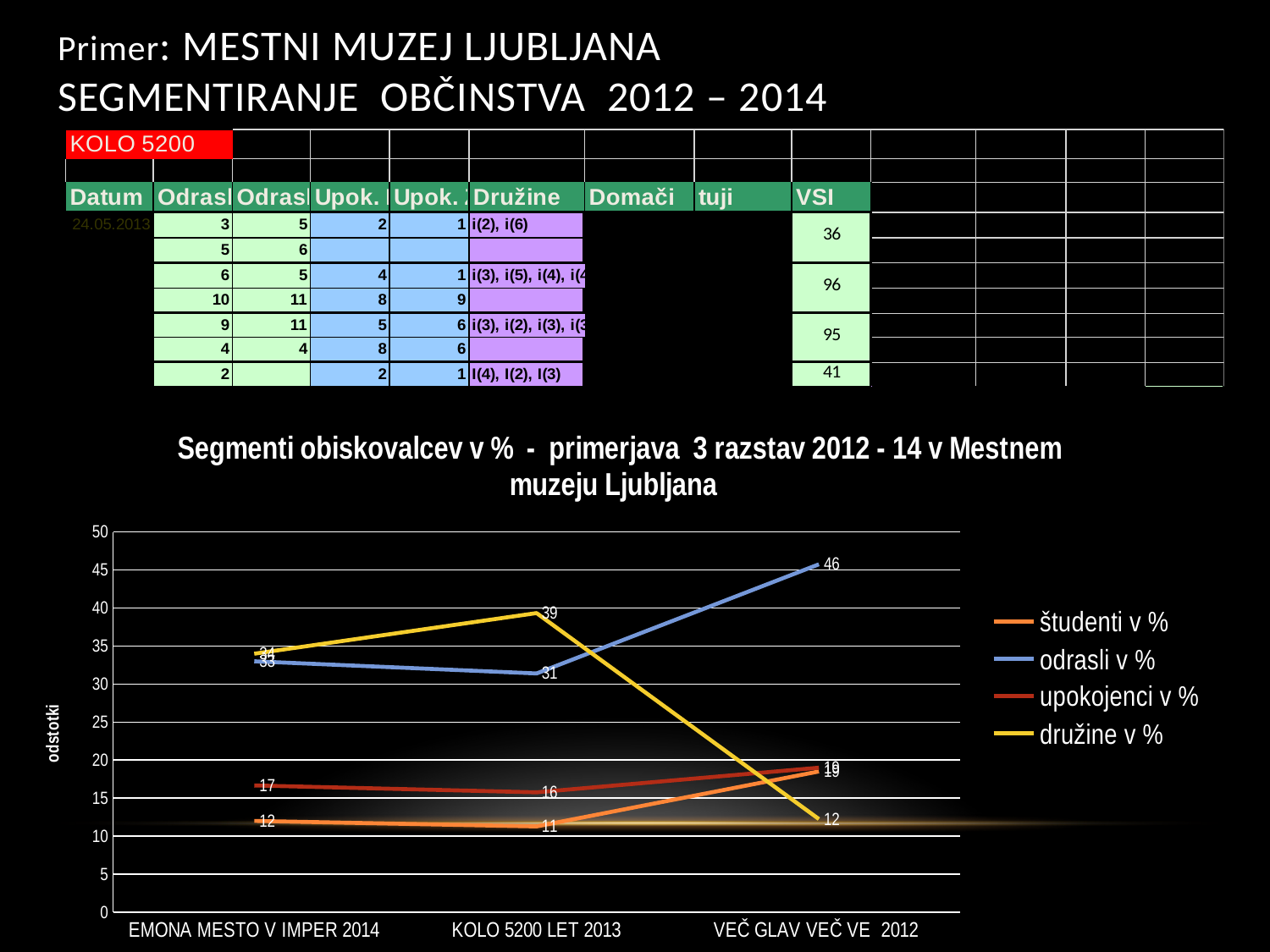
Does 'odrasli v %' rise or fall from KOLO 5200 LET 2013 to VEČ GLAV VEČ VE 2012? rise Which is larger at EMONA MESTO V IMPER 2014: 'upokojenci v %' or 'študenti v %'? upokojenci v % What is the difference between 'družine v %' at KOLO 5200 LET 2013 and at VEČ GLAV VEČ VE 2012? 27 For which category is 'odrasli v %' highest? VEČ GLAV VEČ VE 2012 How many categories are shown on the x axis of the chart? 3 What is the value of 'družine v %' for KOLO 5200 LET 2013? 39 What is the value of 'upokojenci v %' for KOLO 5200 LET 2013? 16 How many series does the chart legend list? 4 For which category is 'družine v %' lowest? VEČ GLAV VEČ VE 2012 What is the value of 'študenti v %' for EMONA MESTO V IMPER 2014? 12 What is the value of 'odrasli v %' for VEČ GLAV VEČ VE 2012? 46 What kind of chart is shown on the slide? line chart